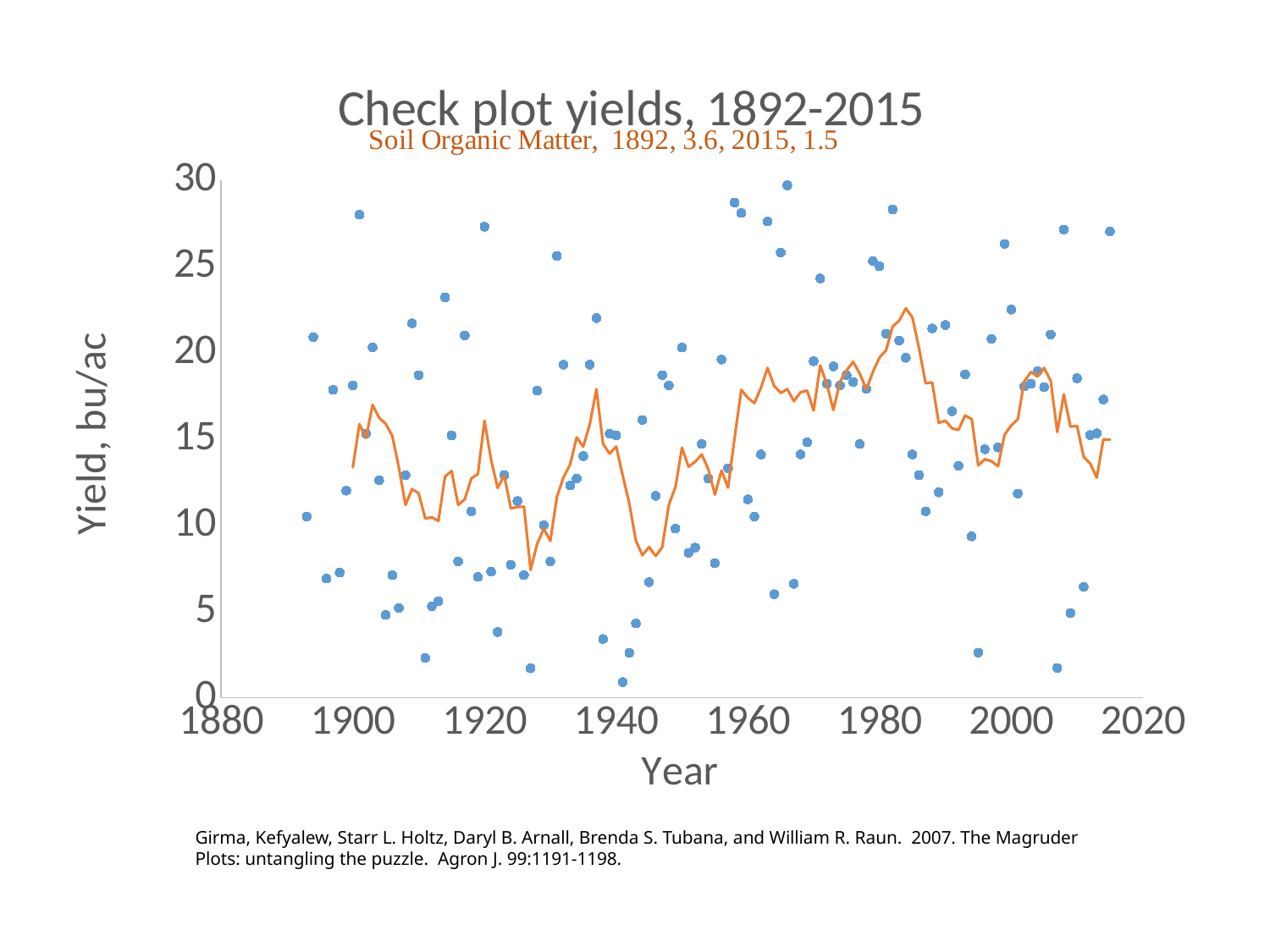
Does the orange line rise or fall between 1985 and 1995? fall What is the highest value shown on the y axis? 30 What is the title of the chart? Check plot yields, 1892-2015 What kind of chart is shown on the slide? scatter plot According to the subtitle, what was the soil organic matter value in 1892? 3.6 According to the subtitle, what was the soil organic matter value in 2015? 1.5 Is the lowest plotted yield value greater or less than 5? less What is the label of the y axis? Yield, bu/ac Is the highest plotted yield value greater or less than 25? greater Does the orange line rise or fall between 1945 and 1960? rise